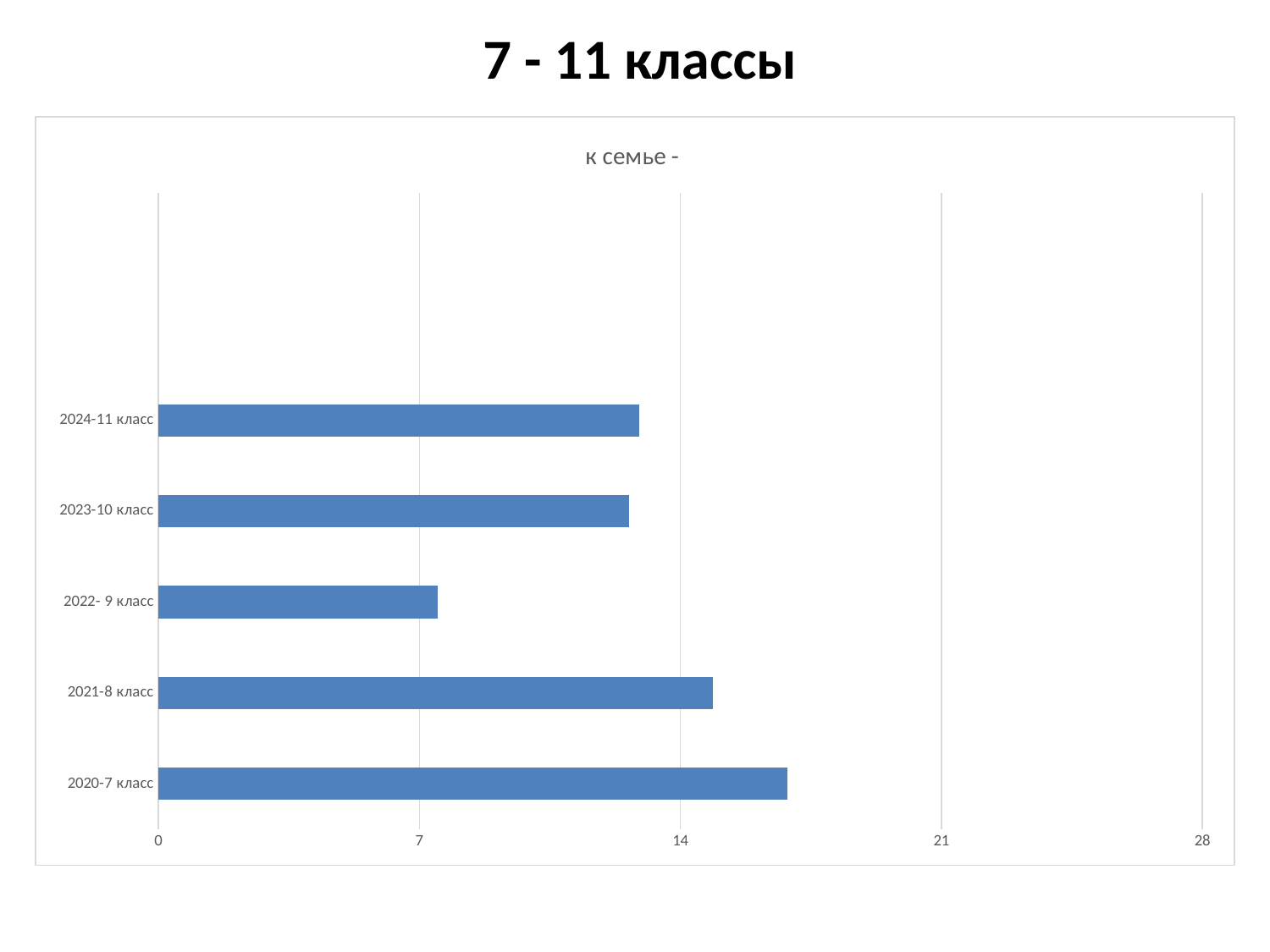
What is the highest value shown on the horizontal axis of the chart? 28 What kind of chart is shown on the slide? bar chart Which category has the lowest value in the chart? 2022- 9 класс Is the value for 2024-11 класс greater or less than 14? less How many categories are plotted in the chart? 5 Which category has the highest value in the chart? 2020-7 класс Which is larger, the value for 2021-8 класс or the value for 2022- 9 класс? 2021-8 класс Is the value for 2020-7 класс greater or less than 14? greater Is the value for 2022- 9 класс greater or less than 14? less What is the title of the chart? к семье -